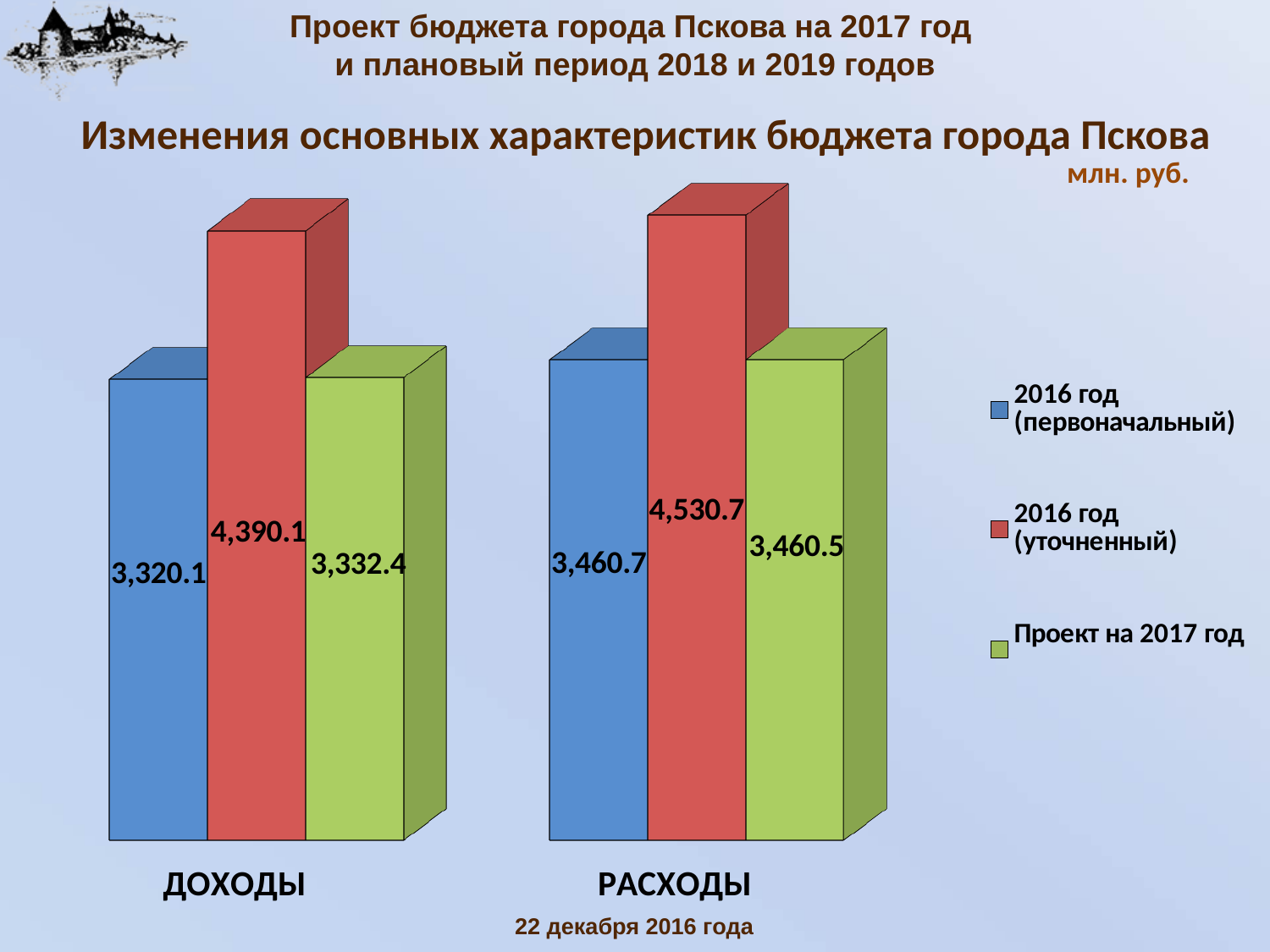
What is the difference between the Проект на 2017 год values for РАСХОДЫ and ДОХОДЫ? 128.1 How many series does the legend list? 3 Which series has the highest value for РАСХОДЫ? 2016 год (уточненный) What is the value for РАСХОДЫ in the series 2016 год (уточненный)? 4,530.7 How many categories are shown on the x axis? 2 What is the difference between the 2016 год (уточненный) and 2016 год (первоначальный) values for ДОХОДЫ? 1,070.0 What is the value for РАСХОДЫ in the series Проект на 2017 год? 3,460.5 What is the value for ДОХОДЫ in the series 2016 год (первоначальный)? 3,320.1 What is the value for ДОХОДЫ in the series 2016 год (уточненный)? 4,390.1 What kind of chart is shown on the slide? Bar chart Which is larger: the 2016 год (уточненный) value for ДОХОДЫ or for РАСХОДЫ? РАСХОДЫ Which series has the lowest value for ДОХОДЫ? 2016 год (первоначальный)